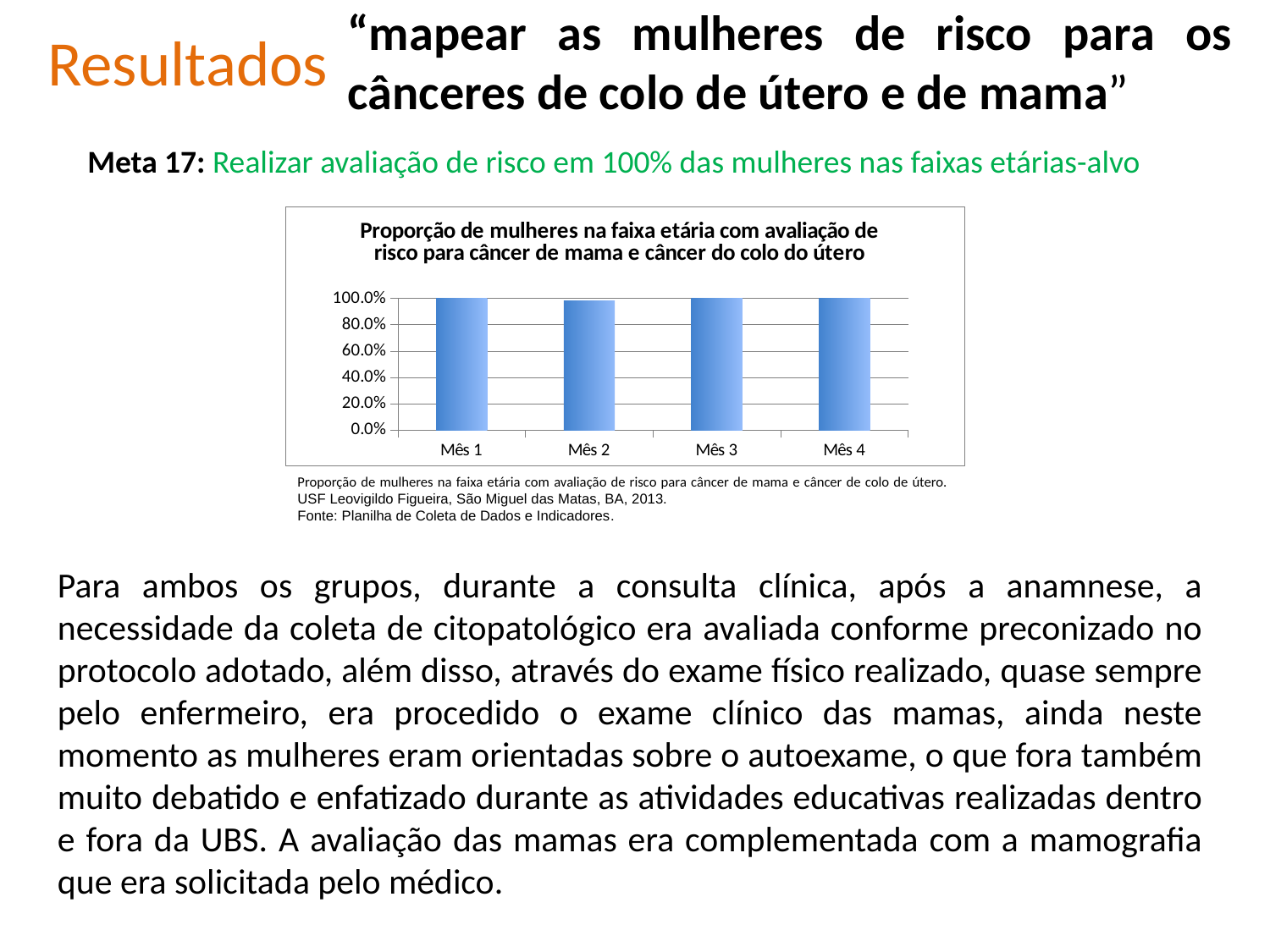
Which is larger, the value for Mês 1 or the value for Mês 2? Mês 1 What is the highest value shown on the y axis of the chart? 100.0% What kind of chart is shown on the slide? bar chart Is the value for Mês 1 greater or less than 60.0%? greater What is the label of the first category on the x axis? Mês 1 Which is larger, the value for Mês 2 or the value for Mês 3? Mês 3 Which month has the lowest value in the chart? Mês 2 Is the value for Mês 2 greater or less than 80.0%? greater What is the title of the chart? Proporção de mulheres na faixa etária com avaliação de risco para câncer de mama e câncer do colo do útero Is the value for Mês 4 greater or less than 80.0%? greater How many months (categories) are shown on the x axis of the chart? 4